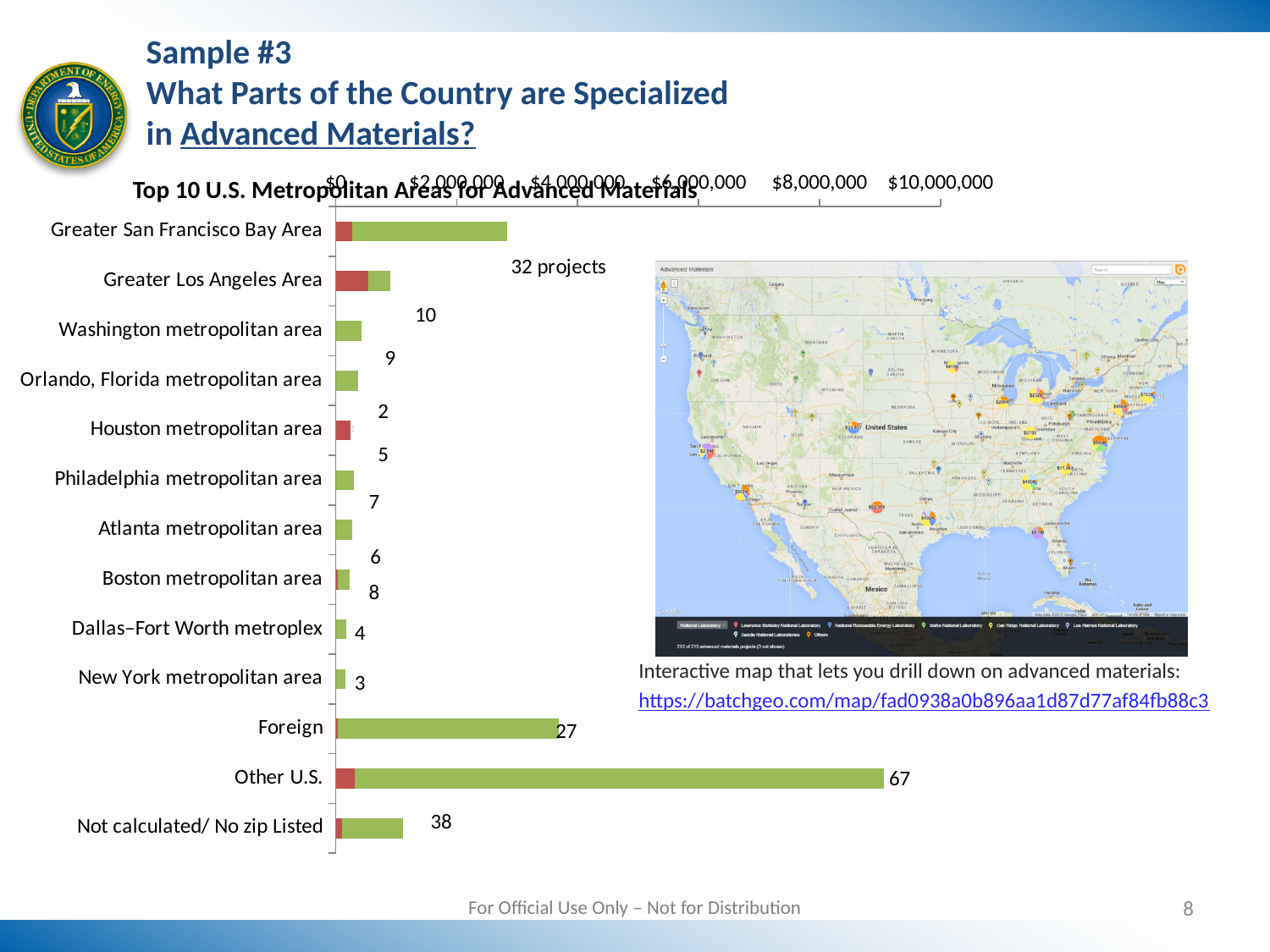
How many categories are listed on the chart's vertical axis? 13 Is the bar value for Greater Los Angeles Area greater or less than $2,000,000? less What kind of chart is shown on the slide? bar chart What is the title of the chart on the slide? Top 10 U.S. Metropolitan Areas for Advanced Materials Which category has the longest bar in the chart? Other U.S. What project count is labeled next to the Foreign bar? 27 How many projects are labeled for the Greater San Francisco Bay Area? 32 projects What project count is labeled next to the Other U.S. bar? 67 What project count is labeled for the Not calculated/ No zip Listed category? 38 How many more projects are labeled for Other U.S. than for Not calculated/ No zip Listed? 29 Which bar is longer, Foreign or Greater San Francisco Bay Area? Foreign Is the bar value for Other U.S. greater or less than $8,000,000? greater